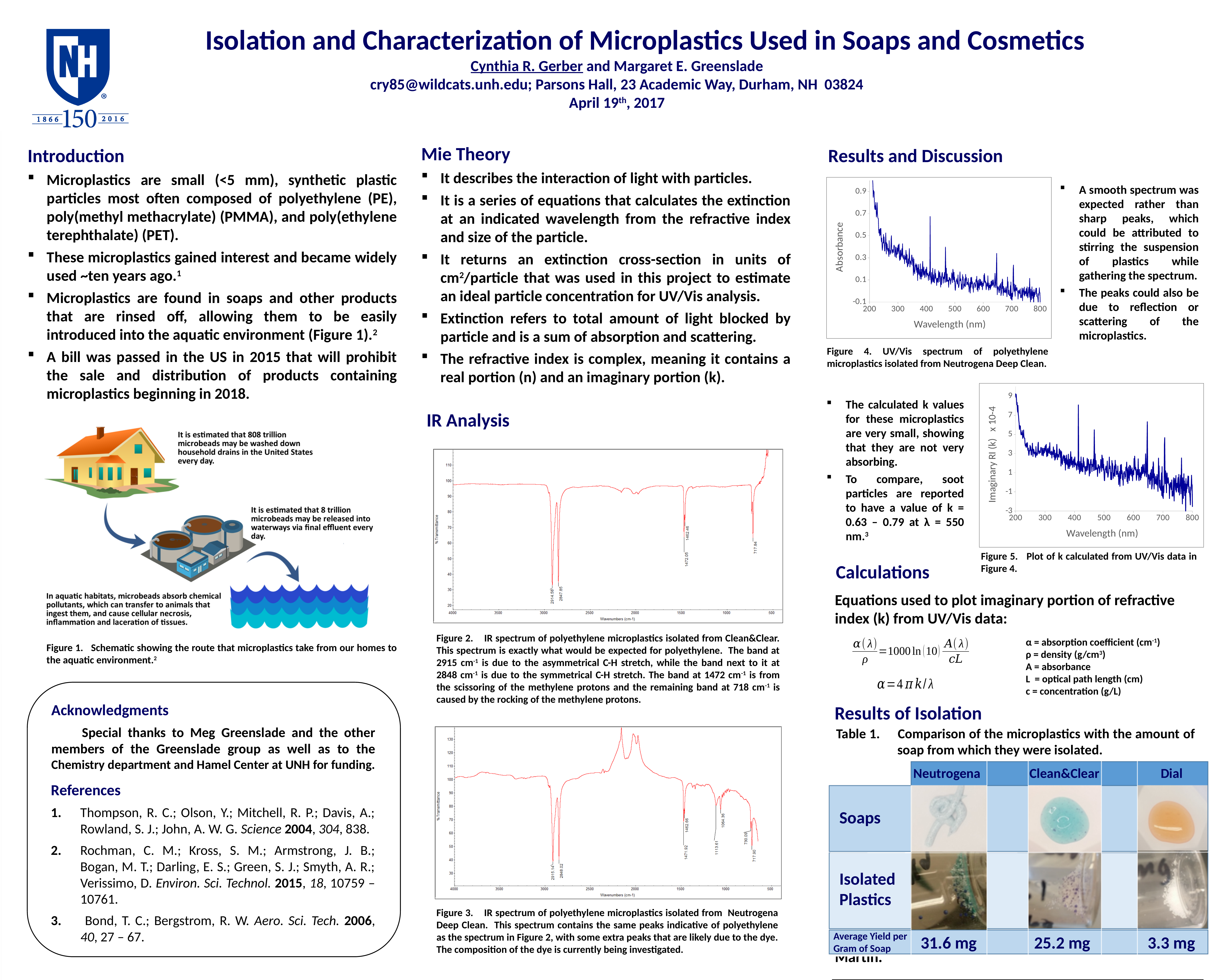
What kind of chart is Figure 4, the UV/Vis spectrum of polyethylene microplastics isolated from Neutrogena Deep Clean? Line chart In Figure 4, the UV/Vis spectrum, does the absorbance generally rise or fall as wavelength increases from 200 nm to 800 nm? Fall In Figure 4, the UV/Vis spectrum, what is the label of the x axis? Wavelength (nm) In Figure 5, the plot of k, is the value near 800 nm greater or less than 3? less What kind of chart is Figure 3, the IR spectrum of polyethylene microplastics isolated from Neutrogena Deep Clean? Line chart How many charts (figures with plotted spectra) are shown on the poster? 4 In Figure 5, the plot of k, is the value at 200 nm greater or less than 7? greater In Figure 4, the UV/Vis spectrum, is the absorbance at 200 nm greater or less than 0.7? greater In Figure 4, the UV/Vis spectrum, what is the label of the y axis? Absorbance In Figure 5, the plot of k calculated from UV/Vis data, does the imaginary refractive index generally rise or fall as wavelength increases? Fall In Figure 2, the IR spectrum of polyethylene microplastics isolated from Clean&Clear, what is the label of the x axis? Wavenumbers (cm-1)